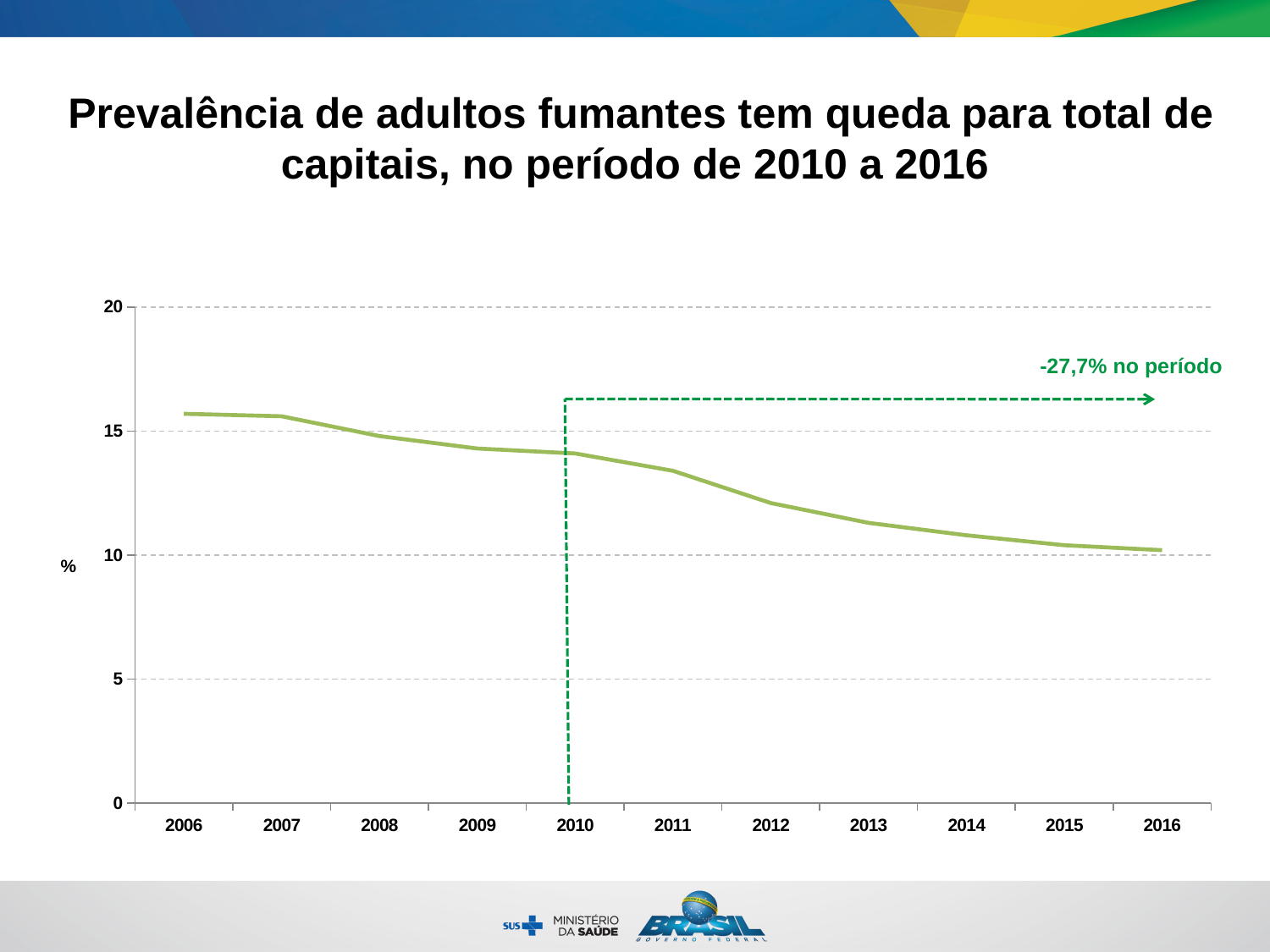
What percentage change over the period is annotated on the chart? -27,7% no período What is the label on the y axis? % Which year has the lowest value? 2016 Is the value for 2012 greater or less than 15? less Is the value for 2006 greater or less than 15? greater Which is larger, the value for 2007 or the value for 2014? 2007 Is the value for 2010 greater or less than 15? less What kind of chart is shown on the slide? line chart How many years are plotted along the x axis? 11 Which year has the highest value? 2006 Do the values rise or fall from 2006 to 2016? fall